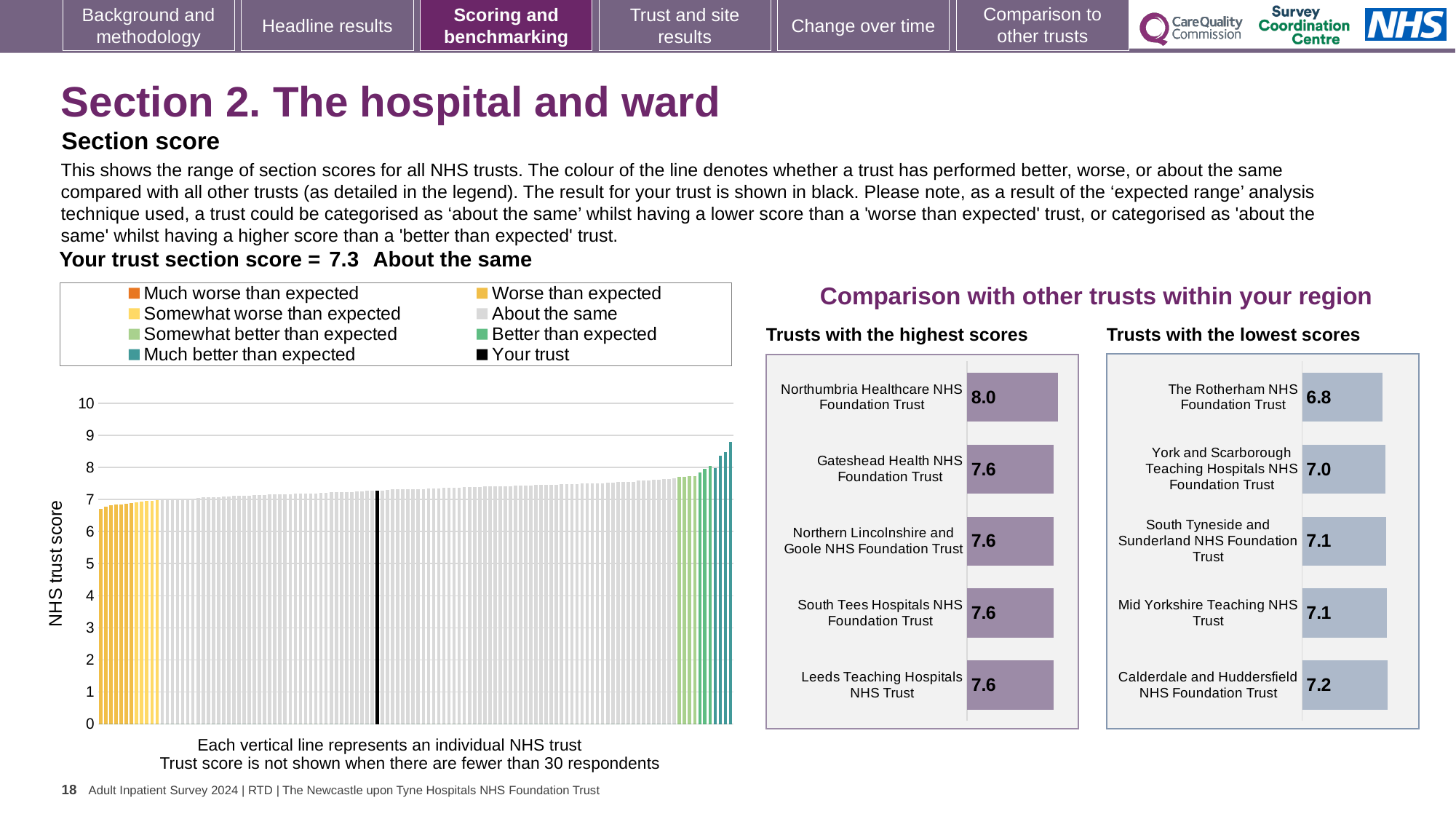
In the large chart on the left showing NHS trust scores, what kind of chart is it? Bar chart In the large chart on the left showing NHS trust scores, how many entries does the legend list? 8 In the 'Trusts with the highest scores' chart, what is the difference between the scores of Northumbria Healthcare NHS Foundation Trust and Gateshead Health NHS Foundation Trust? 0.4 In the 'Trusts with the lowest scores' chart, what is the score for The Rotherham NHS Foundation Trust? 6.8 In the 'Trusts with the highest scores' chart, how many trusts are shown? 5 In the large chart on the left showing NHS trust scores, do the values rise or fall from left to right along the x axis? Rise In the 'Trusts with the lowest scores' chart, which trust has the highest score? Calderdale and Huddersfield NHS Foundation Trust In the 'Trusts with the lowest scores' chart, which trust has the lowest score? The Rotherham NHS Foundation Trust In the 'Trusts with the lowest scores' chart, which has the larger score: York and Scarborough Teaching Hospitals NHS Foundation Trust or Calderdale and Huddersfield NHS Foundation Trust? Calderdale and Huddersfield NHS Foundation Trust In the 'Trusts with the lowest scores' chart, what is the difference between the scores of Calderdale and Huddersfield NHS Foundation Trust and The Rotherham NHS Foundation Trust? 0.4 In the 'Trusts with the highest scores' chart, which trust has the highest score? Northumbria Healthcare NHS Foundation Trust In the 'Trusts with the highest scores' chart, what is the score for Northumbria Healthcare NHS Foundation Trust? 8.0